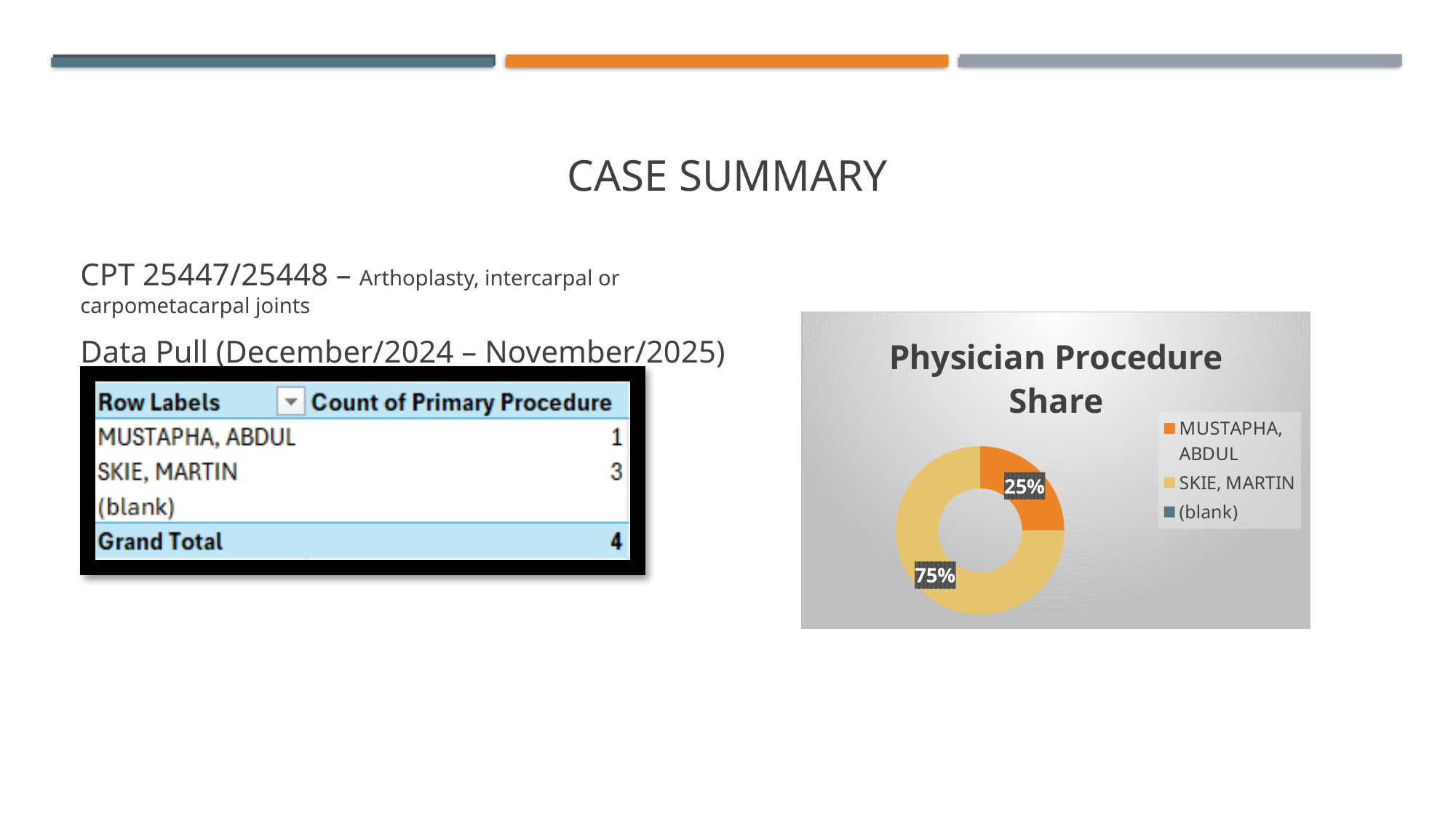
How many entries does the legend of the Physician Procedure Share chart list? 3 In the Physician Procedure Share chart, how many slices have a percentage label shown? 2 What kind of chart is the Physician Procedure Share chart? Pie chart (doughnut) In the Physician Procedure Share chart, which labelled slice is the smallest? MUSTAPHA, ABDUL In the Physician Procedure Share chart, is the share for SKIE, MARTIN larger or smaller than the share for MUSTAPHA, ABDUL? larger In the Physician Procedure Share chart, which physician has the largest share? SKIE, MARTIN In the Physician Procedure Share chart, what colour is the slice for MUSTAPHA, ABDUL? Orange In the Physician Procedure Share chart, what is the difference in percentage points between the SKIE, MARTIN share and the MUSTAPHA, ABDUL share? 50 percentage points What is the title of the chart on the slide? Physician Procedure Share In the Physician Procedure Share chart, what share is labelled for SKIE, MARTIN? 75% In the Physician Procedure Share chart, what share is labelled for MUSTAPHA, ABDUL? 25%